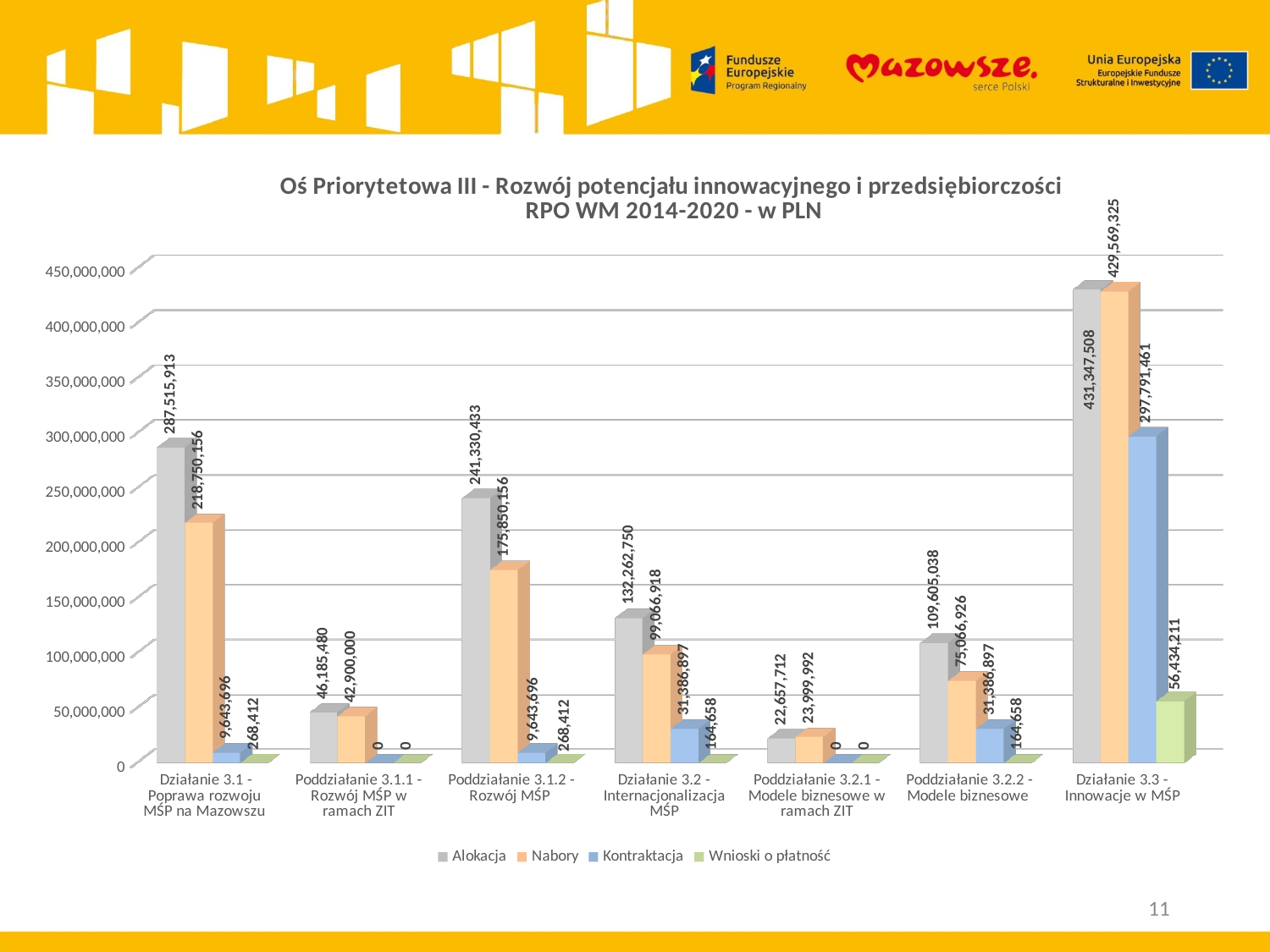
What type of chart is shown on the slide? Bar chart What is the Nabory value for Działanie 3.1 - Poprawa rozwoju MŚP na Mazowszu? 218,750,156 What is the Wnioski o płatność value for Działanie 3.3 - Innowacje w MŚP? 56,434,211 Which category has the highest Alokacja value? Działanie 3.3 - Innowacje w MŚP Which series is shown in green in the legend? Wnioski o płatność How many series does the legend list? 4 Which category has the lowest Alokacja value? Poddziałanie 3.2.1 - Modele biznesowe w ramach ZIT How many categories are shown on the x axis of the chart? 7 What is the Alokacja value for Działanie 3.3 - Innowacje w MŚP? 431,347,508 What is the Kontraktacja value for Działanie 3.2 - Internacjonalizacja MŚP? 31,386,897 What is the difference between Alokacja and Nabory for Działanie 3.1 - Poprawa rozwoju MŚP na Mazowszu? 68,765,757 For Poddziałanie 3.2.1 - Modele biznesowe w ramach ZIT, which is larger: Alokacja or Nabory? Nabory